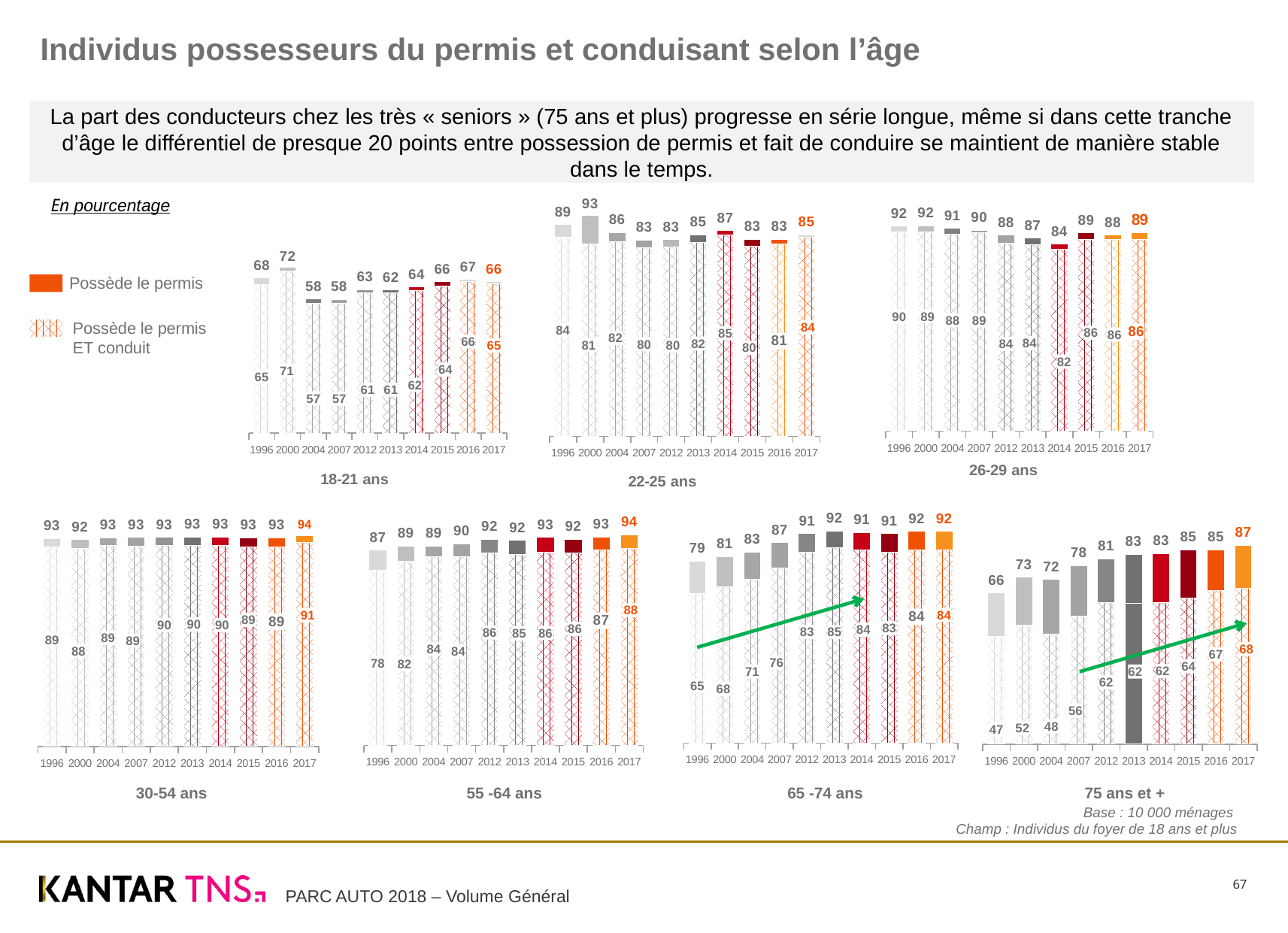
In the '22-25 ans' chart, which is larger: 'Possède le permis' in 2000 or in 2017? 2000 In the '65 -74 ans' chart, which year has the lowest value for 'Possède le permis ET conduit'? 1996 Which legend entry is shown with a solid orange fill? Possède le permis What kind of chart is the '55 -64 ans' chart? bar chart How many series does the legend list? 2 In the '18-21 ans' chart, which year has the highest value for 'Possède le permis'? 2000 In the '65 -74 ans' chart, does the value for 'Possède le permis' rise or fall from 1996 to 2017? rise In the '26-29 ans' chart, what is the value for 'Possède le permis ET conduit' in 2014? 82 How many years are shown on the x axis of the '30-54 ans' chart? 10 In the '75 ans et +' chart, what is the value for 'Possède le permis' in 2017? 87 In the '75 ans et +' chart, what is the value for 'Possède le permis ET conduit' in 1996? 47 In the '75 ans et +' chart, what is the difference between 'Possède le permis' and 'Possède le permis ET conduit' in 2017? 19